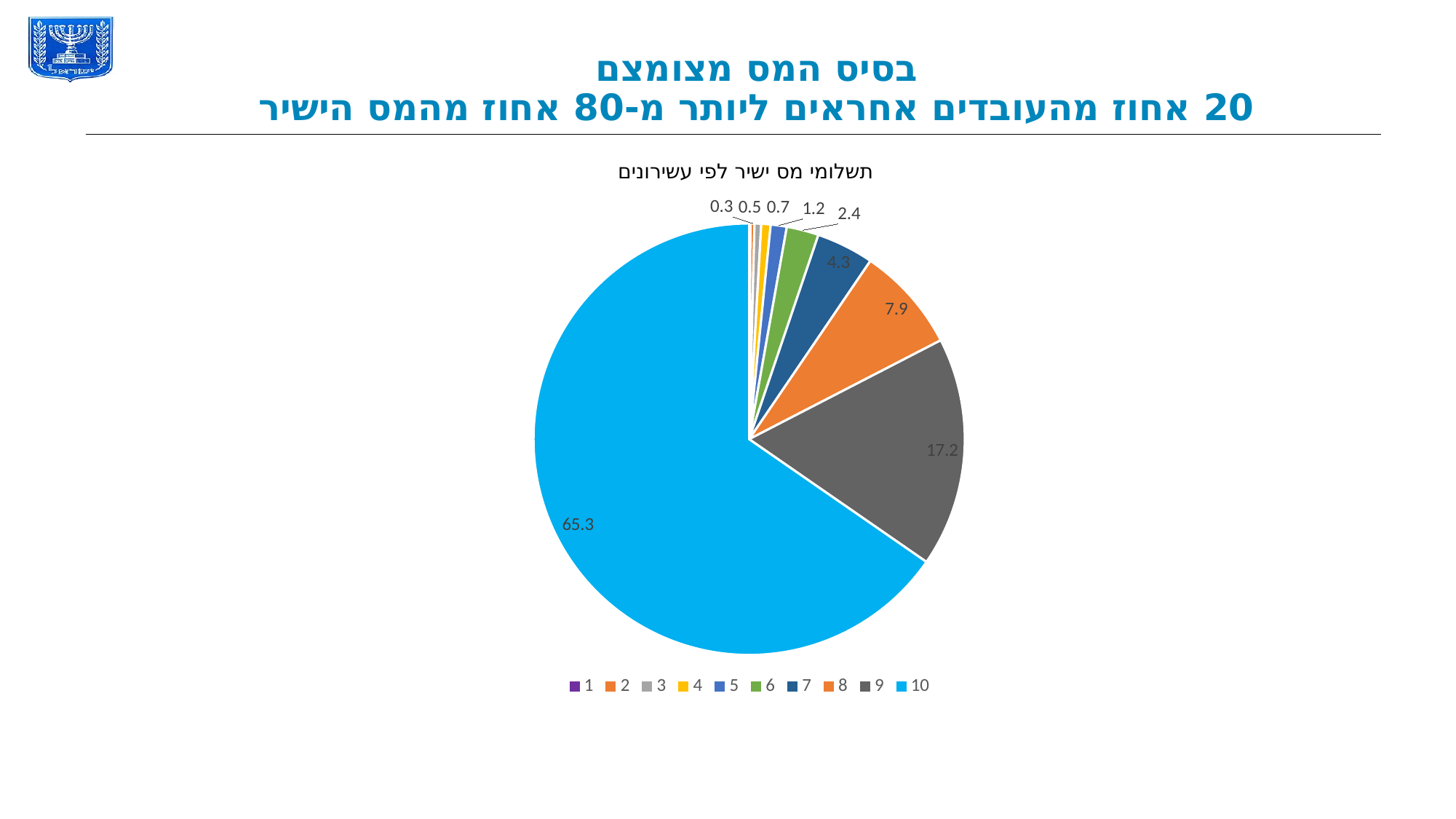
What kind of chart is shown on the slide? pie chart Which decile has the largest slice in the pie chart? 10 What is the difference between the values for decile 10 and decile 9 in the pie chart? 48.1 What is the value shown for decile 9 in the pie chart? 17.2 What is the value shown for decile 8 in the pie chart? 7.9 What is the combined value of deciles 10 and 9 in the pie chart? 82.5 What is the value shown for decile 10 in the pie chart? 65.3 Which has a larger value in the pie chart, decile 9 or decile 8? decile 9 What is the title of the pie chart? תשלומי מס ישיר לפי עשירונים How many entries does the legend of the pie chart list? 10 What is the value shown for decile 7 in the pie chart? 4.3 What is the value shown for decile 6 in the pie chart? 2.4